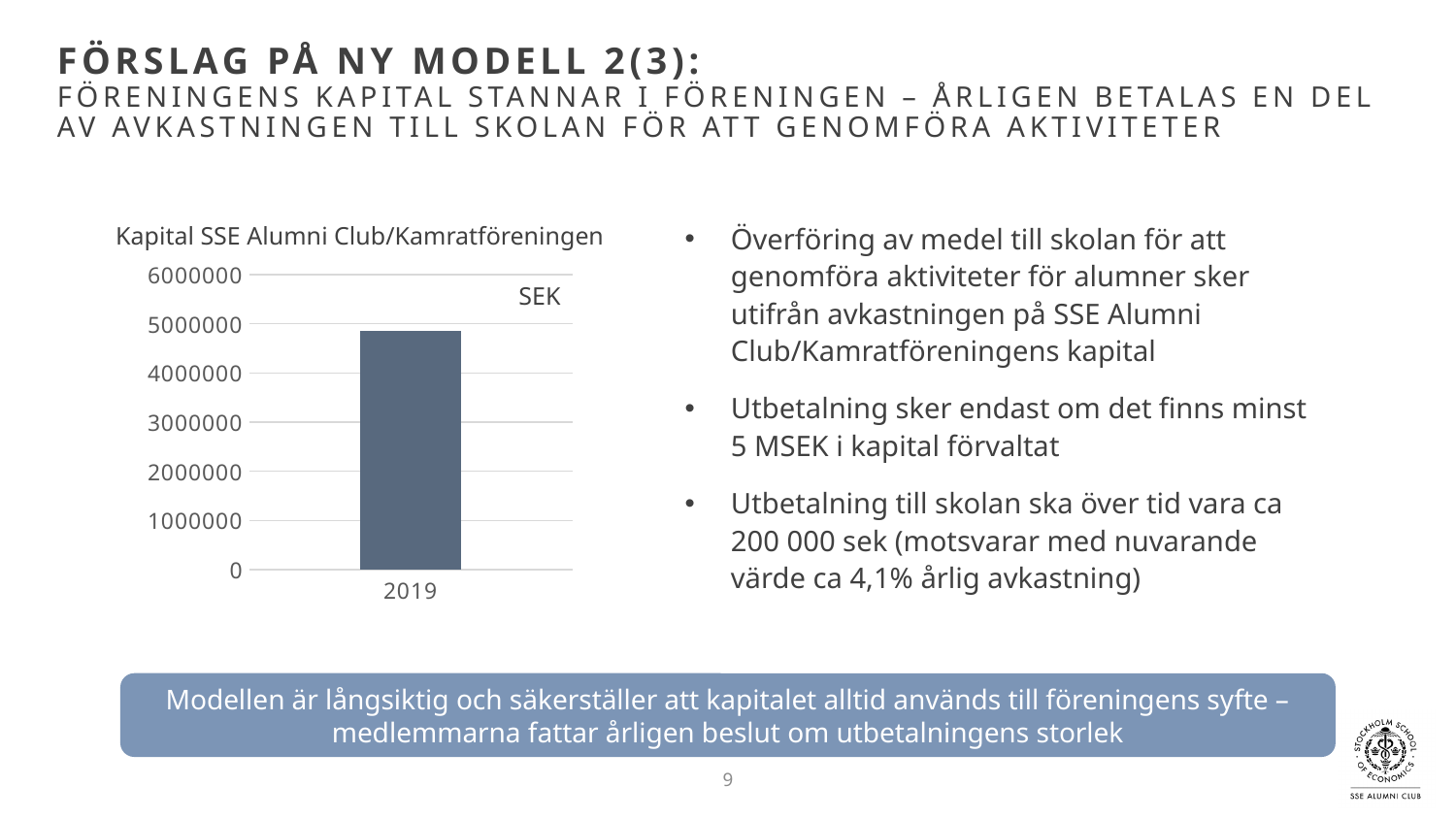
How many series does the chart legend list? 1 What series name is shown in the chart legend? SEK What is the title of the chart? Kapital SSE Alumni Club/Kamratföreningen Is the value for 2019 greater or less than 3000000? greater Which year is shown on the x axis of the chart? 2019 What is the highest value shown on the chart's y axis? 6000000 Is the value for 2019 greater or less than 4000000? greater How many bars are plotted in the chart? 1 What kind of chart is shown on the slide? bar chart Is the value for 2019 greater or less than 5000000? less